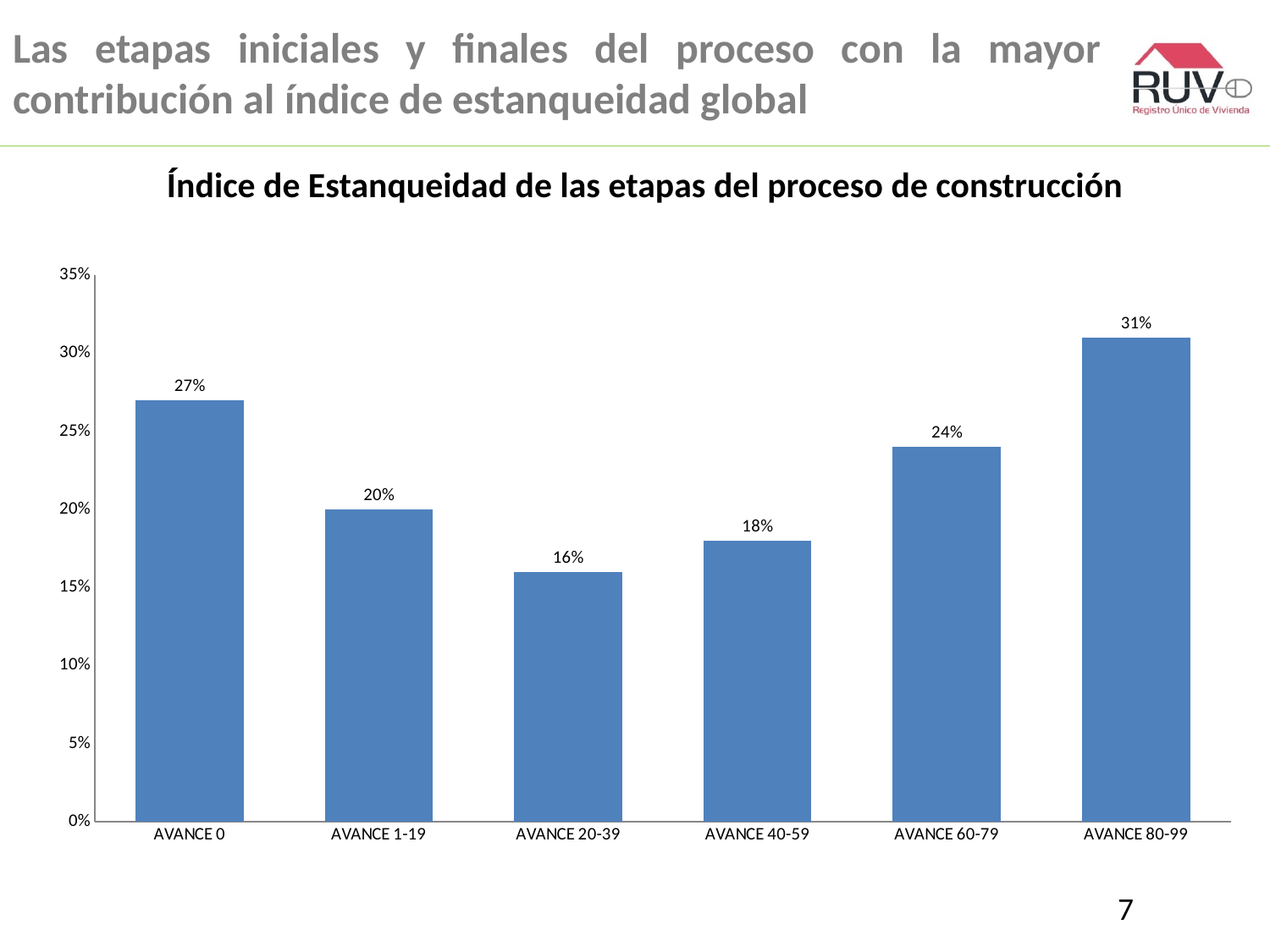
What is the value for AVANCE 20-39? 16% How many categories are shown on the x axis? 6 What is the difference between the values for AVANCE 0 and AVANCE 1-19? 7% What is the difference between the values for AVANCE 80-99 and AVANCE 20-39? 15% What kind of chart is shown on the slide? Bar chart Which is larger, the value for AVANCE 40-59 or the value for AVANCE 60-79? AVANCE 60-79 What is the value for AVANCE 60-79? 24% What is the title of the chart? Índice de Estanqueidad de las etapas del proceso de construcción Is the value for AVANCE 80-99 greater or less than 30%? greater Which category has the highest value? AVANCE 80-99 What is the value for AVANCE 0? 27% Which category has the lowest value? AVANCE 20-39